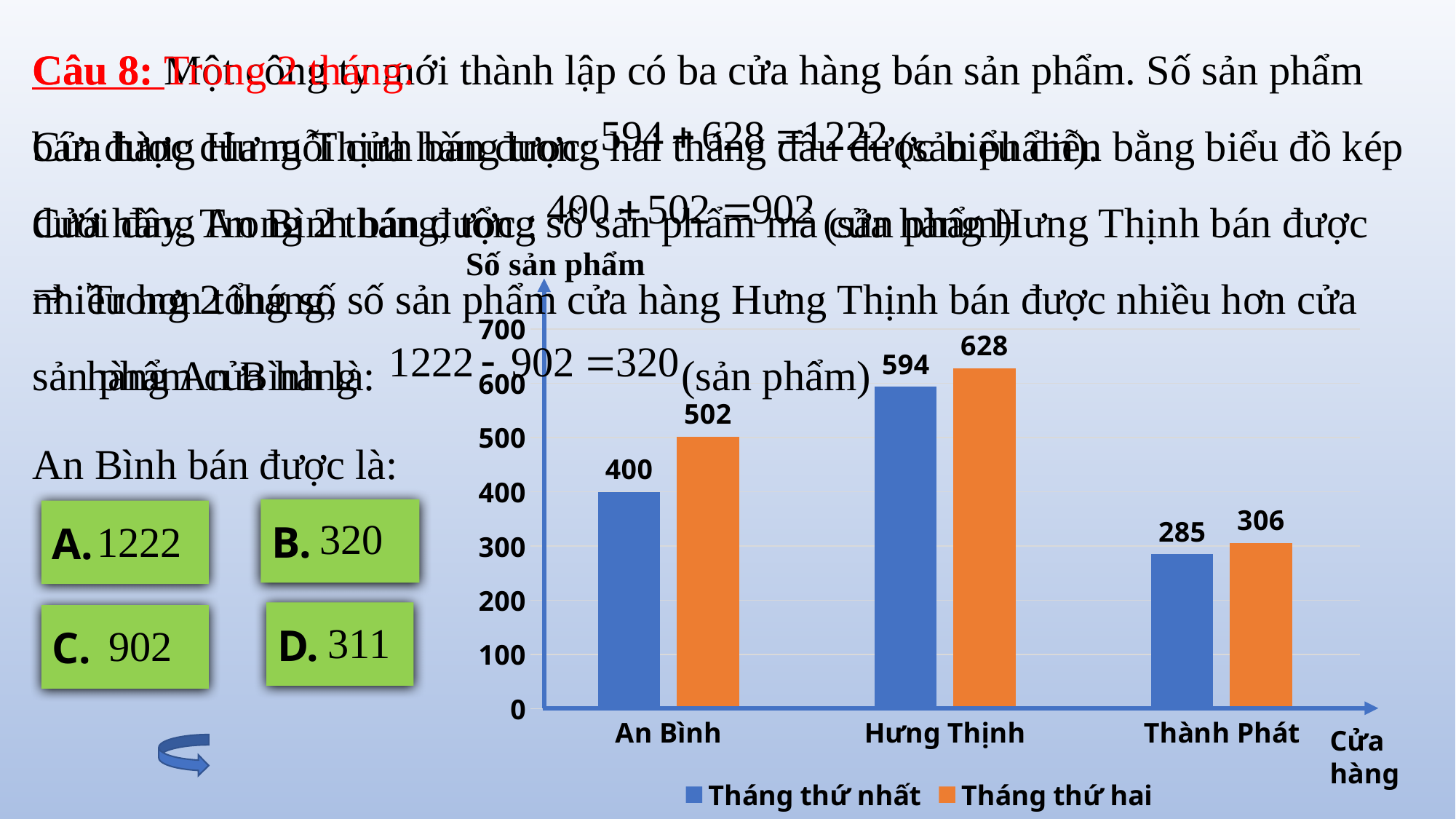
What is the value for An Bình in the Tháng thứ nhất series? 400 Which store has the highest value in the Tháng thứ hai series? Hưng Thịnh What is the value for Thành Phát in the Tháng thứ nhất series? 285 What kind of chart is shown on the slide? bar chart What is the label of the vertical axis of the chart? Số sản phẩm What is the value for Hưng Thịnh in the Tháng thứ hai series? 628 How many stores are shown on the x axis of the chart? 3 How many series does the chart legend list? 2 Which store has the lowest value in the Tháng thứ nhất series? Thành Phát Which is larger for Thành Phát: the Tháng thứ nhất value or the Tháng thứ hai value? Tháng thứ hai What is the difference between the Tháng thứ hai and Tháng thứ nhất values for An Bình? 102 Is the Tháng thứ nhất value for Hưng Thịnh greater or less than 500? greater